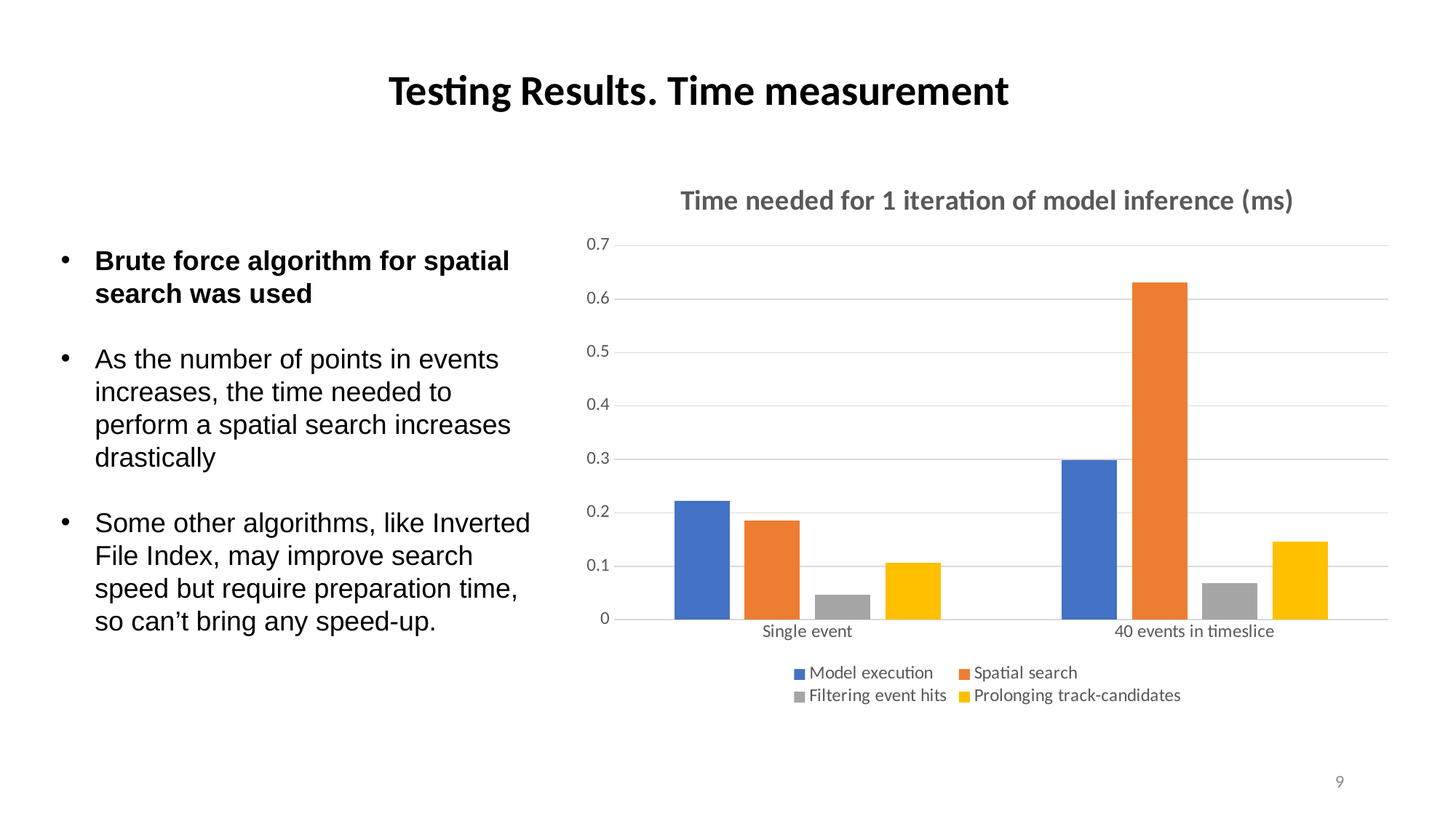
How many series does the legend list? 4 Which is larger: Spatial search for Single event or Spatial search for 40 events in timeslice? 40 events in timeslice What is the title of the chart? Time needed for 1 iteration of model inference (ms) Is the value for Filtering event hits at Single event greater or less than 0.1? less Which series has the highest value for 40 events in timeslice? Spatial search Is the value for Prolonging track-candidates at 40 events in timeslice greater or less than 0.2? less Is the value for Spatial search at 40 events in timeslice greater or less than 0.6? greater Which series has the highest value for Single event? Model execution What kind of chart is shown on the slide? bar chart Does the Spatial search value rise or fall from Single event to 40 events in timeslice? rise Which series has the lowest value for Single event? Filtering event hits How many categories are shown on the x axis? 2